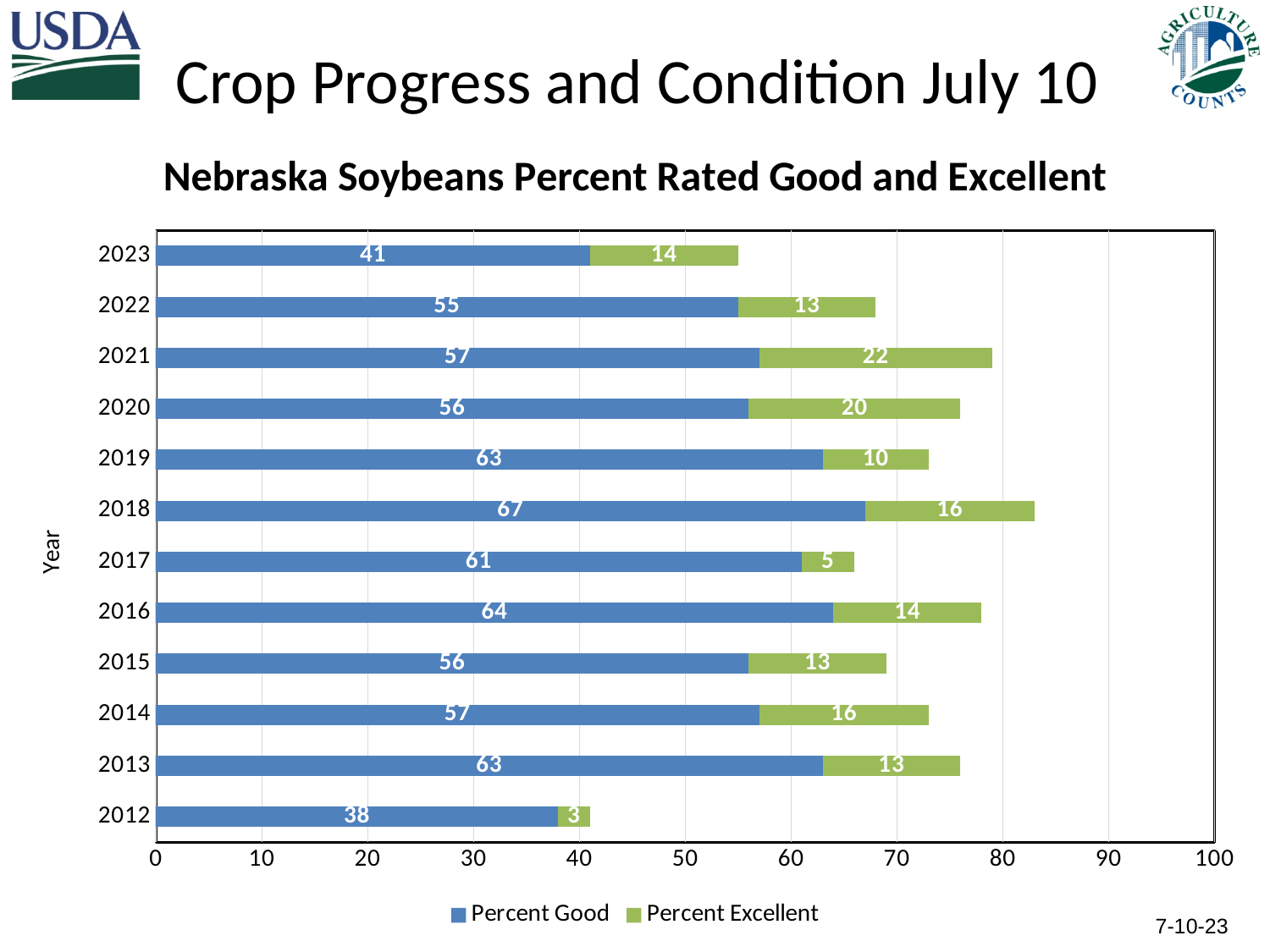
What is the total of the stacked bar for 2018? 83 Which is larger, the Percent Excellent value for 2020 or for 2019? 2020 What kind of chart is shown on the slide? Stacked bar chart What is the difference between the Percent Good values for 2022 and 2023? 14 What is the Percent Excellent value for 2021? 22 How many series does the legend list? 2 Which year has the highest Percent Good value? 2018 How many years are shown on the chart? 12 What is the title of the chart? Nebraska Soybeans Percent Rated Good and Excellent What is the total of the stacked bar for 2012? 41 What is the Percent Good value for 2023? 41 Which year has the lowest Percent Excellent value? 2012